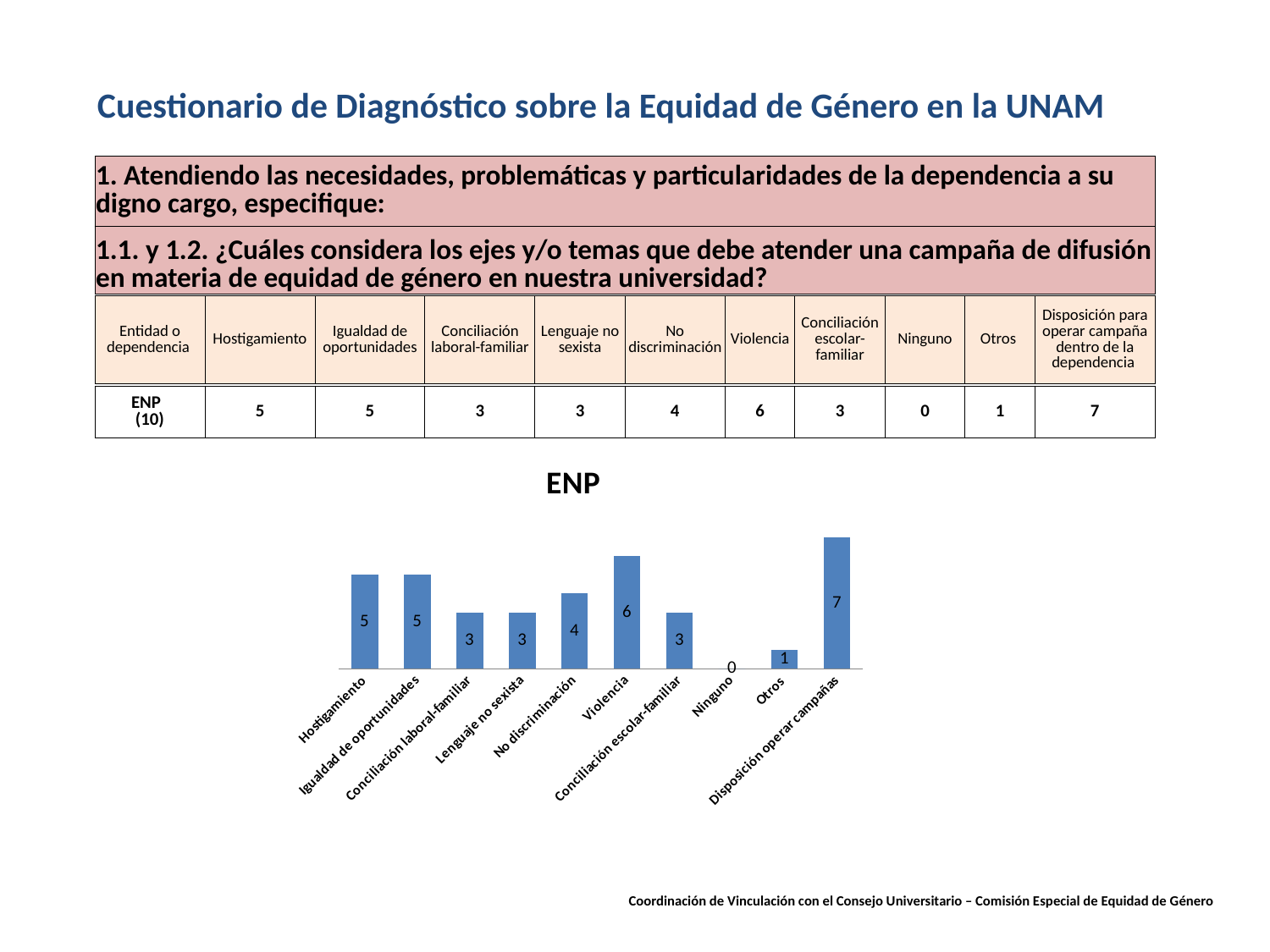
Which category has the lowest value in the ENP chart? Ninguno What is the difference between the values for Disposición operar campañas and Violencia in the ENP chart? 1 What is the title of the chart on the slide? ENP What is the value for Otros in the ENP chart? 1 How many categories are shown in the ENP chart? 10 What is the value for Violencia in the ENP chart? 6 What is the value for Hostigamiento in the ENP chart? 5 What kind of chart is the ENP chart? bar chart Which category has the highest value in the ENP chart? Disposición operar campañas What is the value for Conciliación escolar-familiar in the ENP chart? 3 Which is larger in the ENP chart, Violencia or Igualdad de oportunidades? Violencia What is the difference between the values for No discriminación and Lenguaje no sexista in the ENP chart? 1